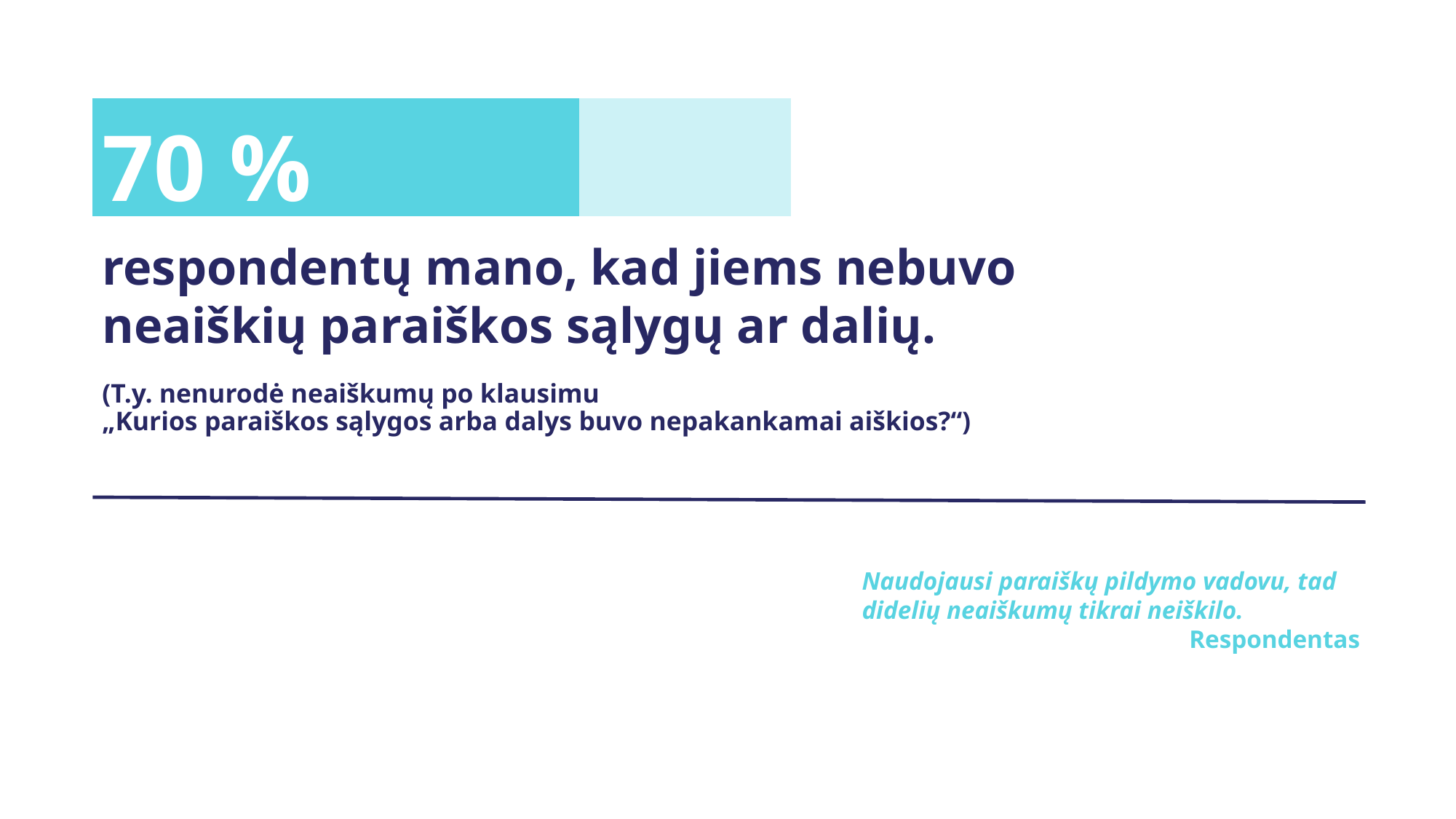
What kind of chart is shown on the slide? bar chart How many bars are shown on the slide? 1 Is the value shown on the bar greater or less than 50%? greater Is the filled portion of the bar larger or smaller than the unfilled portion? larger What does the 70 % on the bar represent, according to the text below it? respondentų mano, kad jiems nebuvo neaiškių paraiškos sąlygų ar dalių What percentage of respondents is shown on the bar on the slide? 70 %